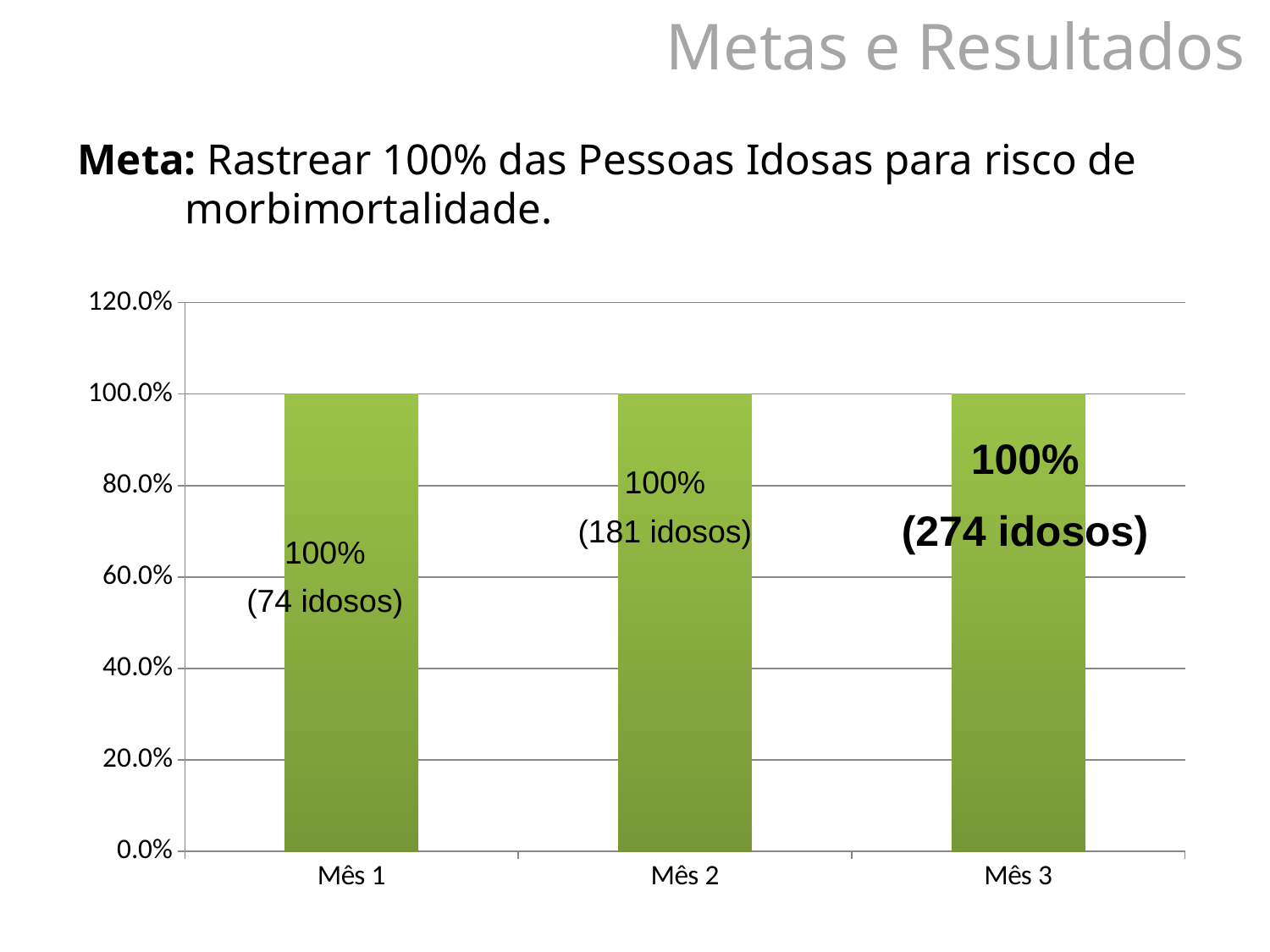
What percentage is shown for Mês 3? 100% How many categories (months) are plotted on the x axis? 3 How many idosos are indicated in the data label for Mês 1? 74 idosos What kind of chart is shown on the slide? bar chart How many more idosos are shown for Mês 2 than for Mês 1? 107 How many idosos are indicated in the data label for Mês 3? 274 idosos What percentage is shown for Mês 1? 100% How many idosos are indicated in the data label for Mês 2? 181 idosos How many more idosos are shown for Mês 3 than for Mês 2? 93 Do the percentage values rise, fall, or stay the same from Mês 1 to Mês 3? stay the same What is the highest tick value shown on the y axis? 120.0% Is the value for Mês 2 greater or less than 80.0%? greater